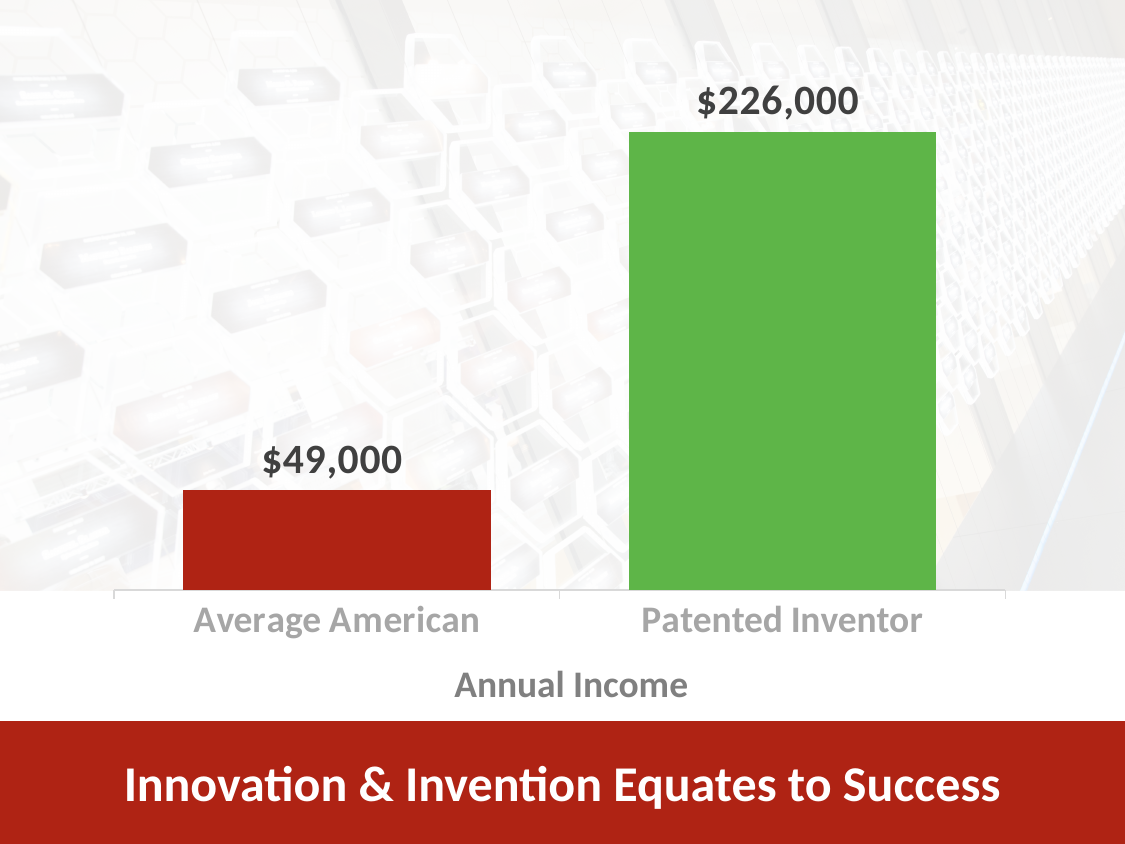
Which category has the lowest annual income? Average American What is the annual income shown for Patented Inventor? $226,000 Which is larger, the annual income for Average American or for Patented Inventor? Patented Inventor What is the annual income shown for Average American? $49,000 What kind of chart is shown on the slide? Bar chart What is the label on the horizontal axis of the chart? Annual Income How many categories are shown in the chart? 2 What colour is the bar for Patented Inventor? Green Which category has the highest annual income? Patented Inventor What is the difference in annual income between Patented Inventor and Average American? $177,000